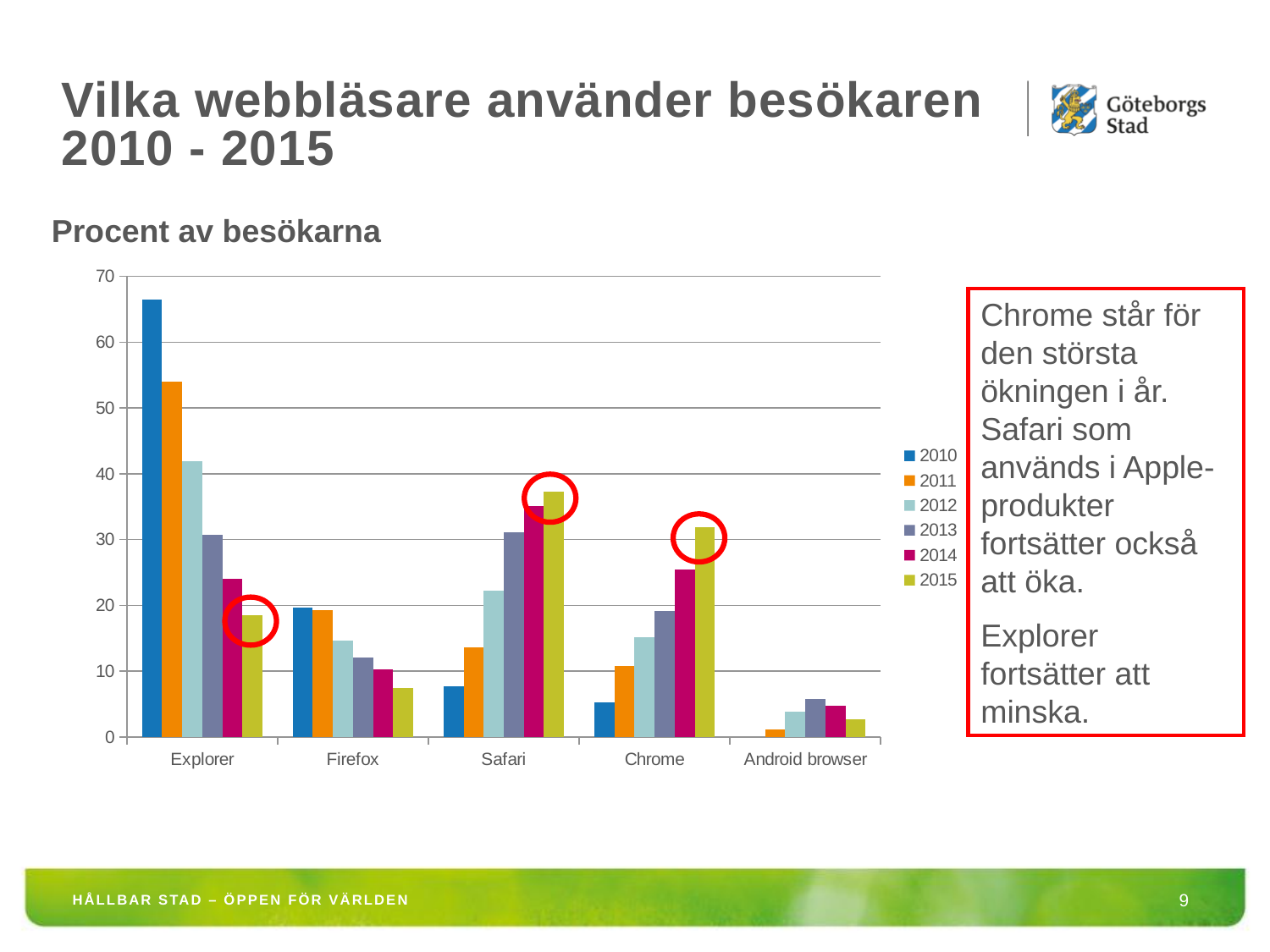
Do the values for Safari rise or fall from 2010 to 2015? rise Do the values for Explorer rise or fall from 2010 to 2015? fall Is the value for Safari in 2015 greater or less than 30? greater Is the value for Explorer in 2015 greater or less than 20? less What is the label shown above the chart describing the measured quantity? Procent av besökarna Which is larger in 2015, the value for Safari or the value for Chrome? Safari Which browser has the lowest value in 2015? Android browser Is the value for Explorer in 2010 greater or less than 60? greater What kind of chart is shown on the slide? bar chart How many browser categories are shown on the x axis? 5 Which browser and year has the tallest bar in the chart? Explorer, 2010 How many series does the legend list? 6